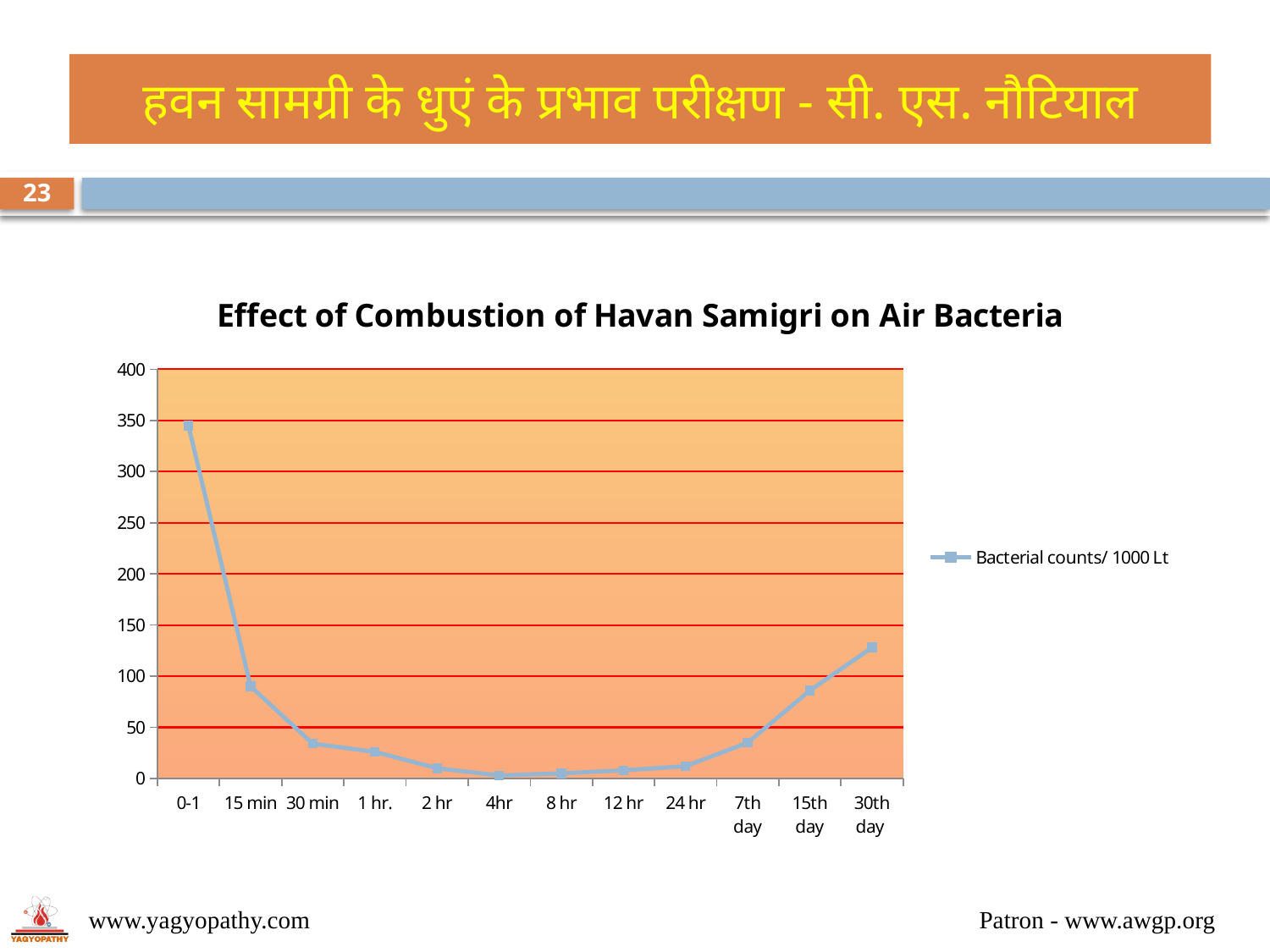
What is the name of the series shown in the legend? Bacterial counts/ 1000 Lt Do the values rise or fall from 0-1 to 4hr? fall Is the value at 30th day greater or less than 100? greater Which has the larger value, 0-1 or 30th day? 0-1 Is the value at 7th day greater or less than 50? less How many series does the legend list? 1 What kind of chart is shown on the slide? line chart Is the value at 0-1 greater or less than 300? greater What is the title of the chart? Effect of Combustion of Havan Samigri on Air Bacteria How many time points are plotted along the x axis? 12 At which time point is the bacterial count highest? 0-1